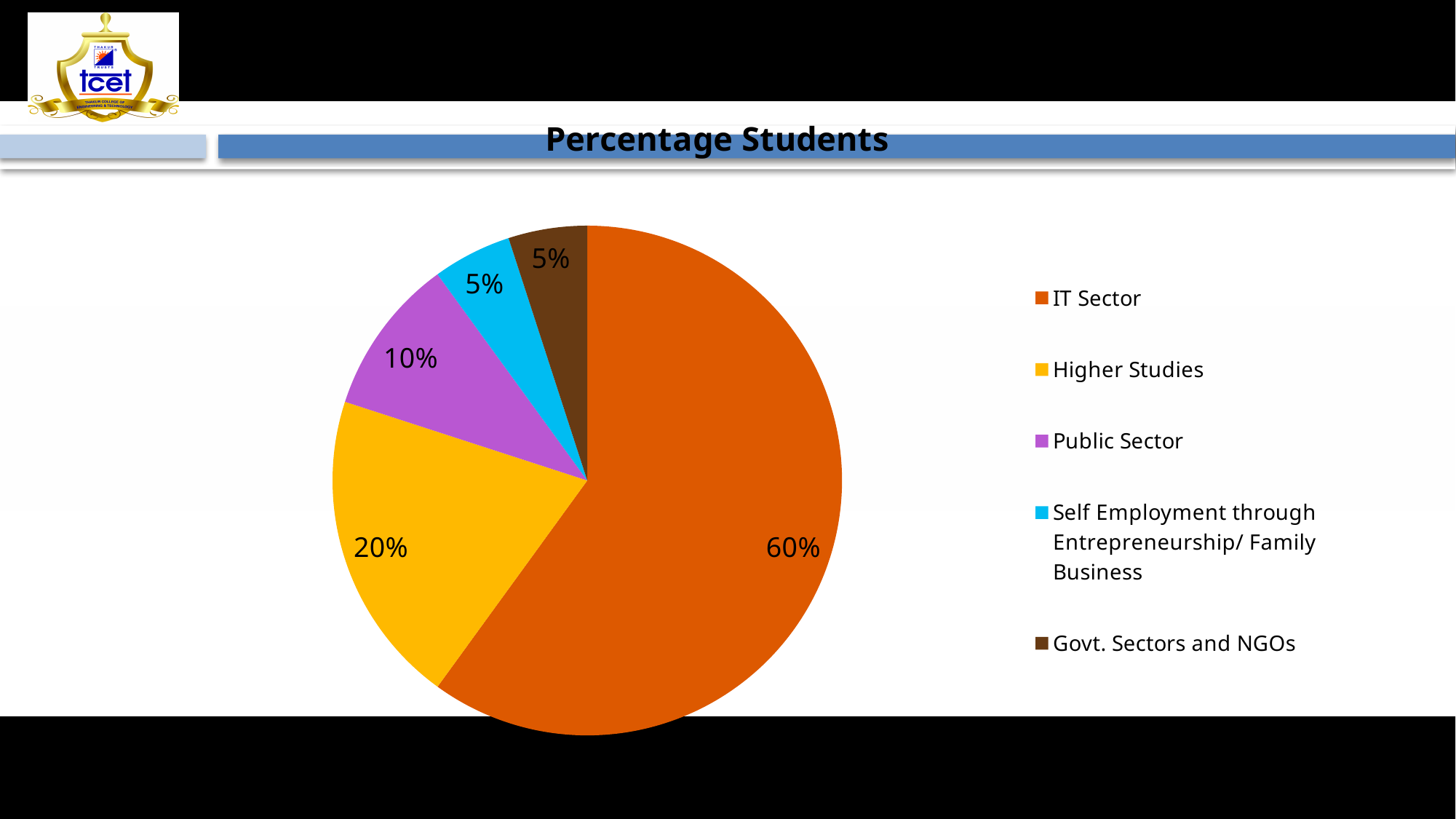
What is the difference between the IT Sector share and the Higher Studies share? 40% What percentage of students is shown for Higher Studies? 20% What percentage of students is shown for Govt. Sectors and NGOs? 5% What percentage of students is shown for Public Sector? 10% How many categories does the legend list? 5 What is the title of the chart? Percentage Students What kind of chart is shown on the slide? pie chart Which category has the largest share of the pie? IT Sector Which is larger, the share for Higher Studies or the share for Public Sector? Higher Studies What is the combined share of Public Sector and Higher Studies? 30% What percentage of students is shown for IT Sector? 60% What colour is the slice for Self Employment through Entrepreneurship/ Family Business? light blue